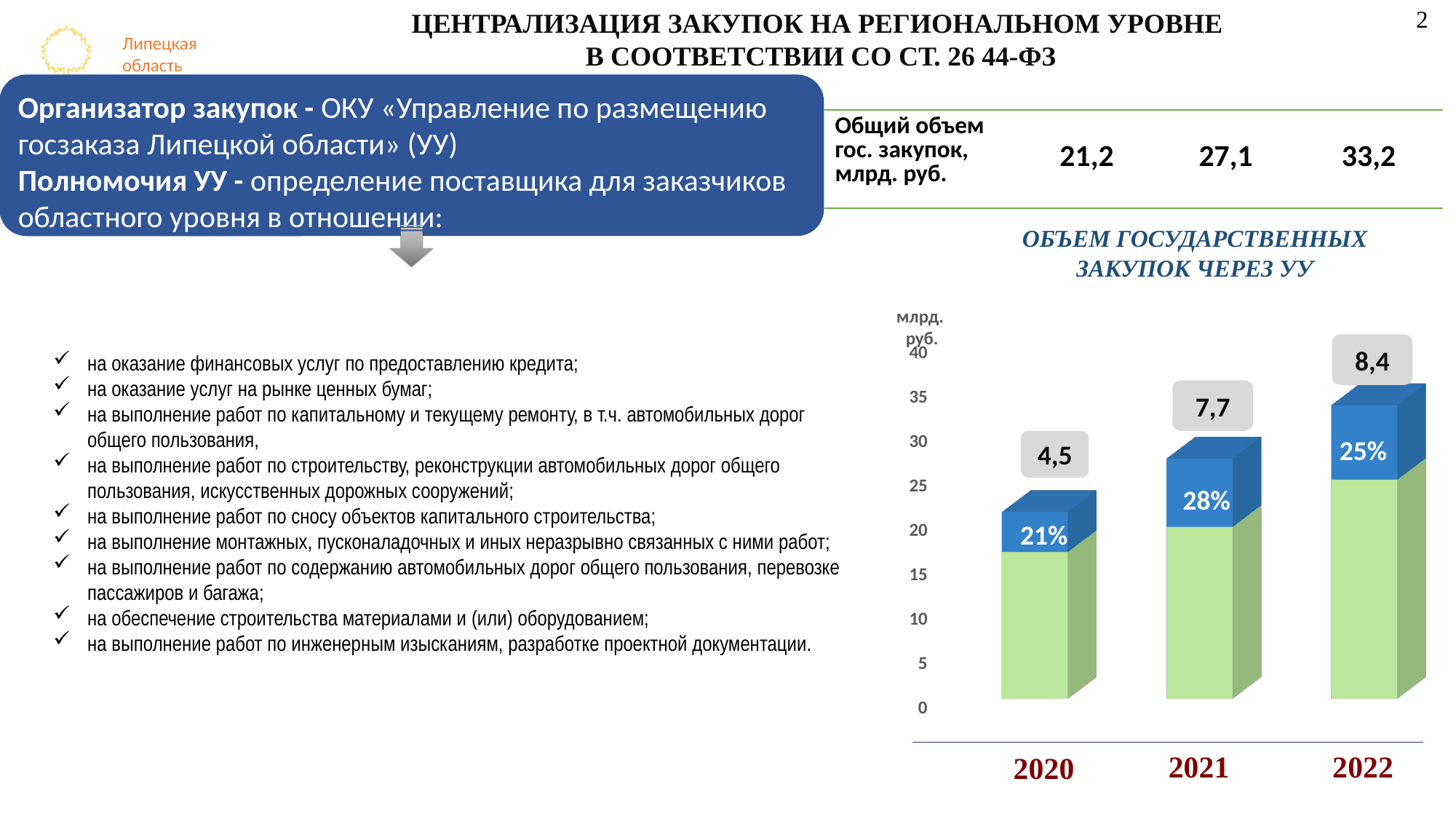
Is the total height of the 2022 bar greater or less than 30? greater Do the volumes through UU rise or fall from 2020 to 2022? rise How many years are shown on the x axis of the chart? 3 Which is larger, the percentage labelled for 2021 or for 2022? 2021 Which year has the highest volume of purchases through UU? 2022 Which year has the lowest percentage labelled on its blue segment? 2020 What percentage is labelled on the blue segment of the 2022 bar? 25% What is the difference between the volume through UU in 2022 and in 2020? 3,9 What percentage is labelled on the blue segment of the 2021 bar? 28% What kind of chart is shown on the slide? bar chart What is the volume of state purchases through UU shown for 2022? 8,4 What is the volume of state purchases through UU shown for 2020? 4,5